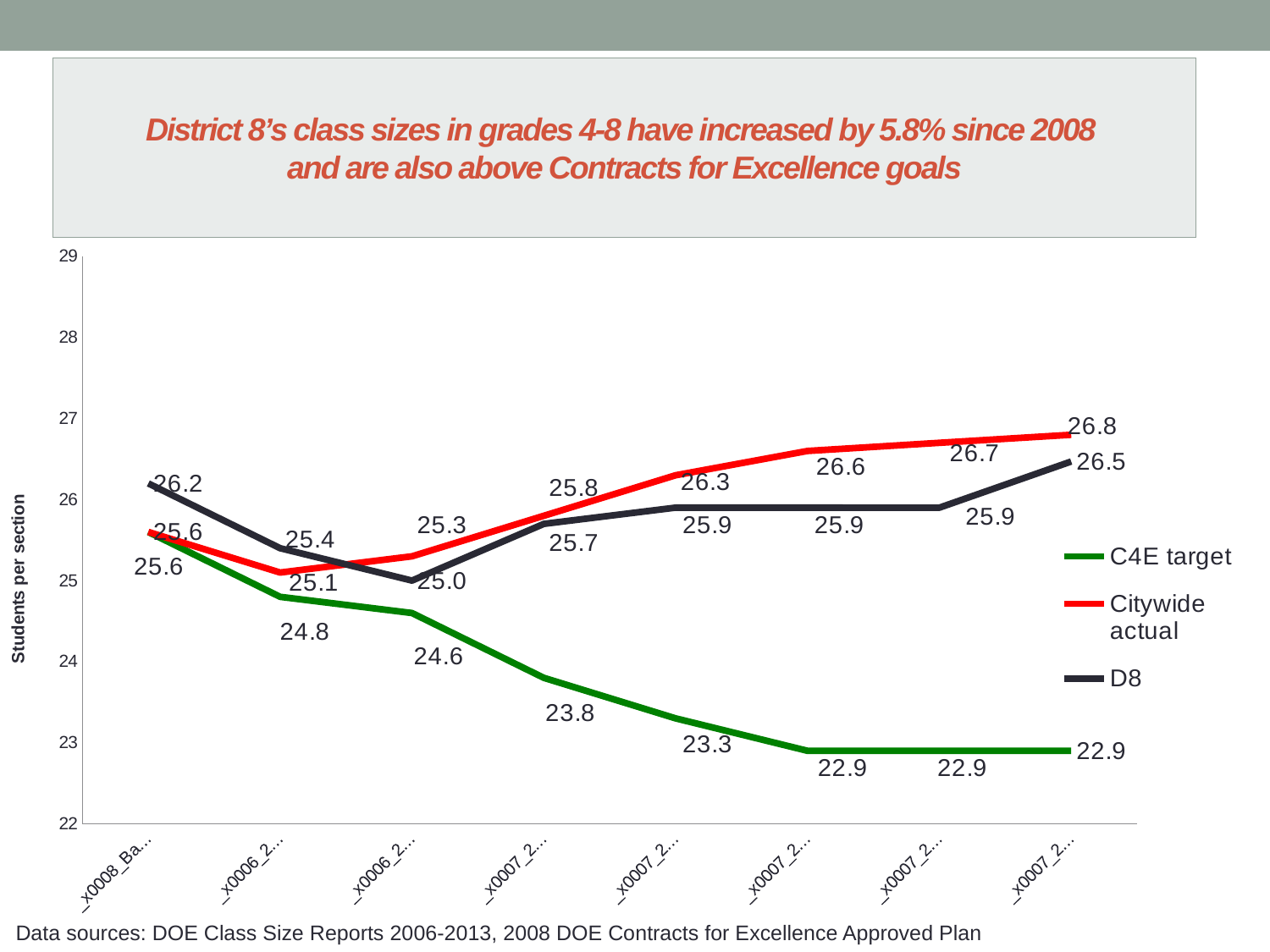
By how much does the Citywide actual value at the rightmost point exceed its value at the leftmost point? 1.2 What is the value of the D8 series at the leftmost point? 26.2 What is the title of the vertical axis? Students per section What type of chart is shown on the slide? Line chart Does the C4E target line rise or fall from left to right? Fall What is the value of the Citywide actual series at the rightmost point? 26.8 What is the highest value plotted for the D8 series? 26.5 At the rightmost point, what is the difference between the D8 value and the C4E target value? 3.6 How many data points does each line have? 8 At the rightmost point, which is larger: Citywide actual or D8? Citywide actual How many series does the legend list? 3 What is the lowest value plotted for the C4E target series? 22.9